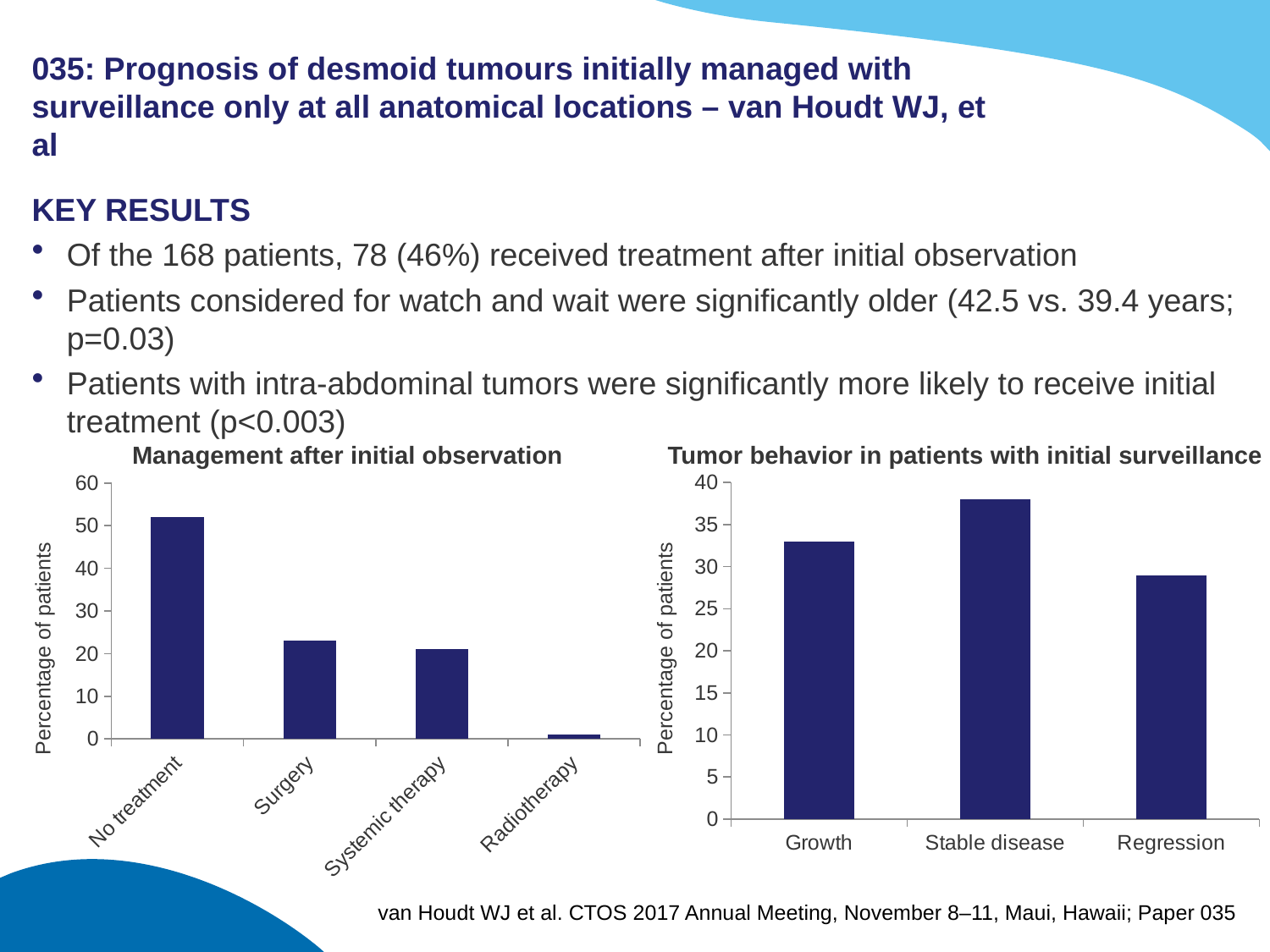
How many categories are shown in the 'Management after initial observation' chart? 4 In the 'Tumor behavior in patients with initial surveillance' chart, which is larger, Growth or Regression? Growth In the 'Tumor behavior in patients with initial surveillance' chart, which category has the lowest percentage of patients? Regression What kind of chart is 'Tumor behavior in patients with initial surveillance'? Bar chart In the 'Management after initial observation' chart, which category has the highest percentage of patients? No treatment In the 'Tumor behavior in patients with initial surveillance' chart, which category has the highest percentage of patients? Stable disease What is the y-axis label of the 'Tumor behavior in patients with initial surveillance' chart? Percentage of patients In the 'Tumor behavior in patients with initial surveillance' chart, is the value for Growth greater or less than 30? greater In the 'Management after initial observation' chart, is the value for Radiotherapy greater or less than 10? less In the 'Management after initial observation' chart, is the value for No treatment greater or less than 50? greater In the 'Management after initial observation' chart, which category has the lowest percentage of patients? Radiotherapy